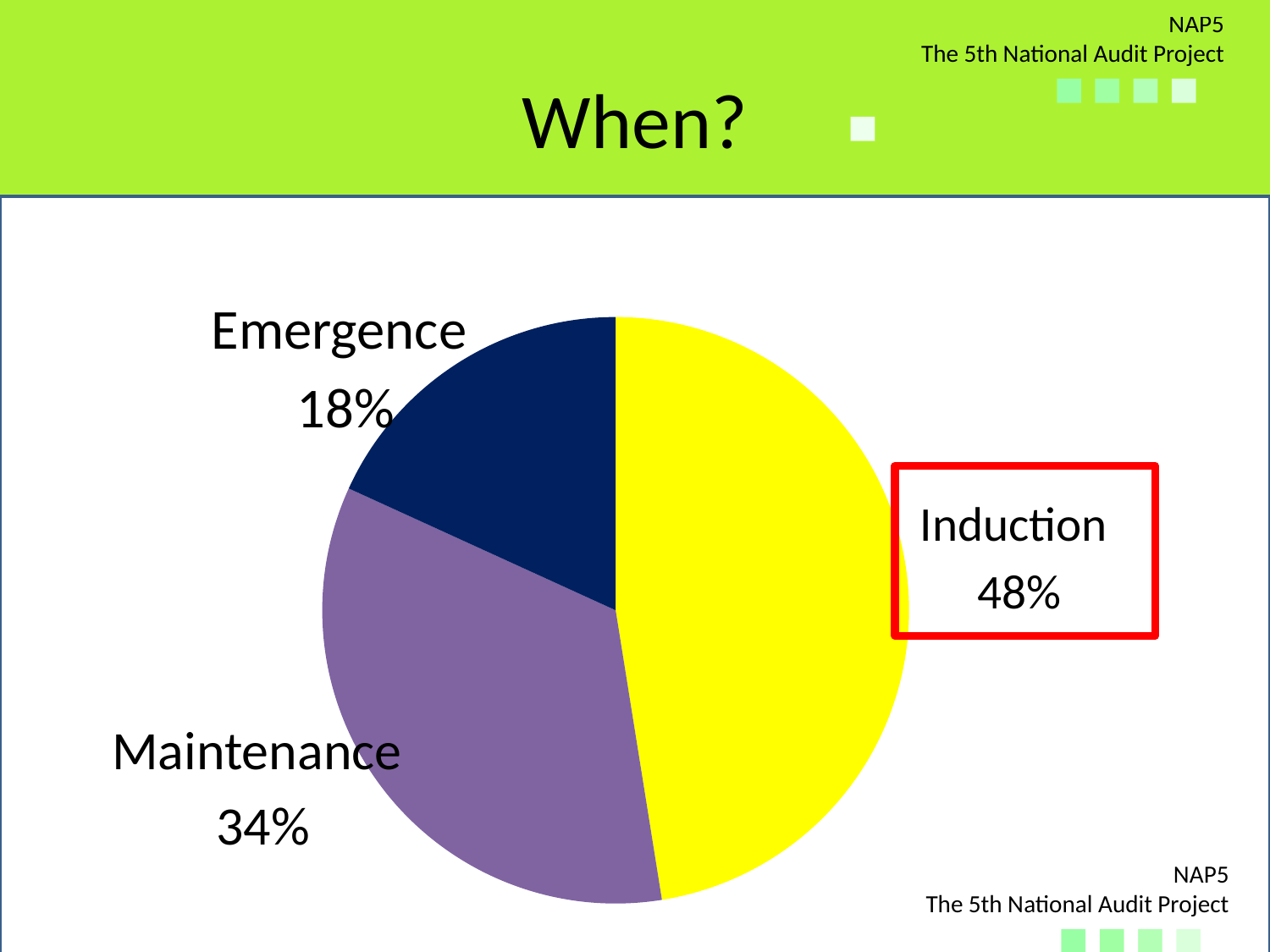
What percentage of the pie is Maintenance? 34% Which slice's label is highlighted with a red box? Induction What is the title of the slide containing the pie chart? When? What kind of chart is shown on the slide? pie chart What is the difference in percentage points between Maintenance and Emergence? 16 Which is larger, the Maintenance slice or the Emergence slice? Maintenance Which slice of the pie is the largest? Induction What percentage of the pie is Induction? 48% What is the difference in percentage points between Induction and Maintenance? 14 How many slices does the pie chart have? 3 Which slice of the pie is the smallest? Emergence What percentage of the pie is Emergence? 18%